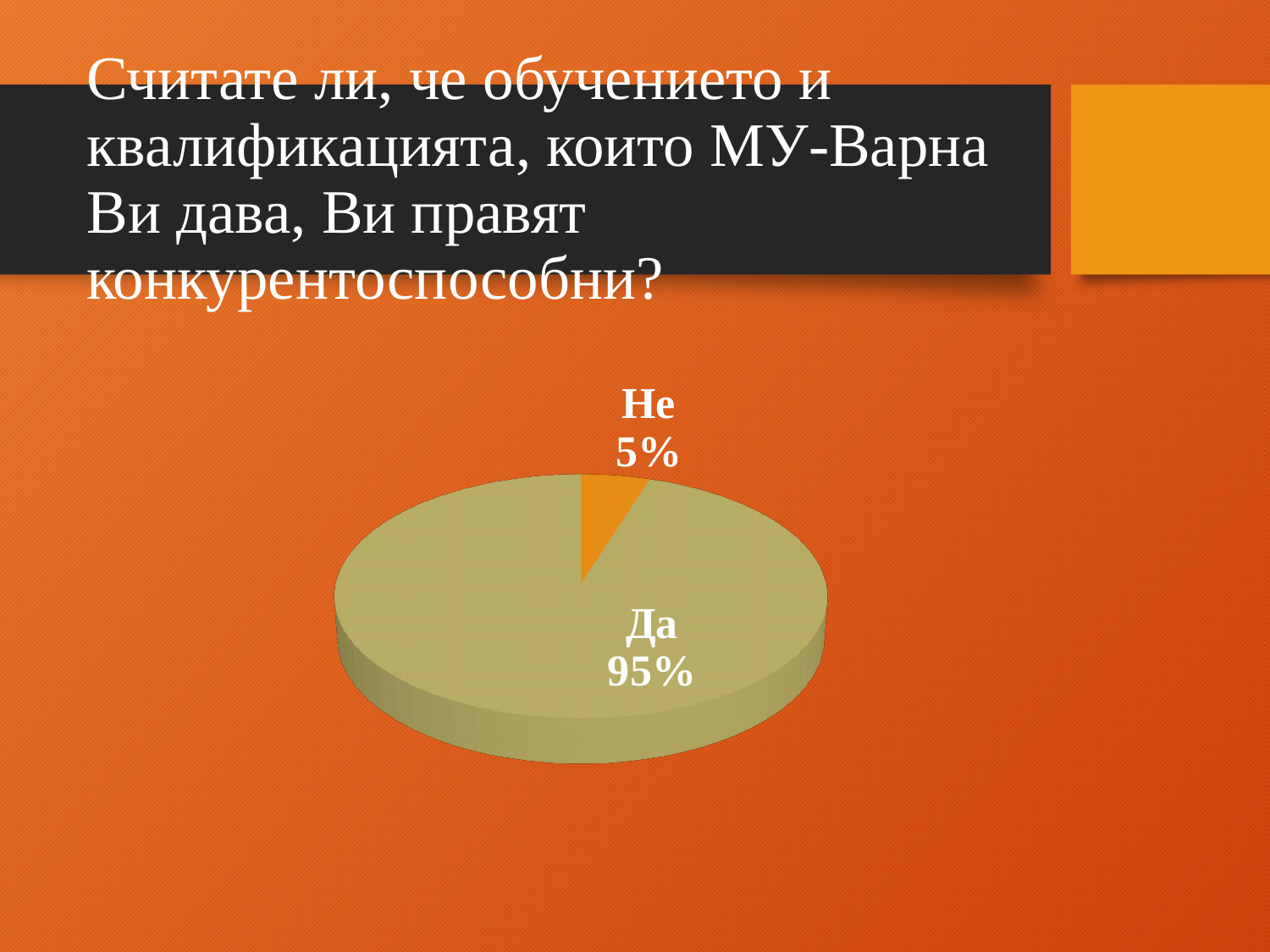
What share of the pie does "Не" represent? 5% How many slices does the pie chart have? 2 What kind of chart is shown on the slide? pie chart What is the label of the slice shown in olive/khaki colour? Да What is the difference in percentage points between the "Да" and "Не" slices? 90 What colour is the "Не" slice of the pie? orange Which slice of the pie is the largest? Да What is the combined share of the "Да" and "Не" slices? 100% What share of the pie does "Да" represent? 95% Which is larger, the "Да" slice or the "Не" slice? Да Which slice of the pie is the smallest? Не